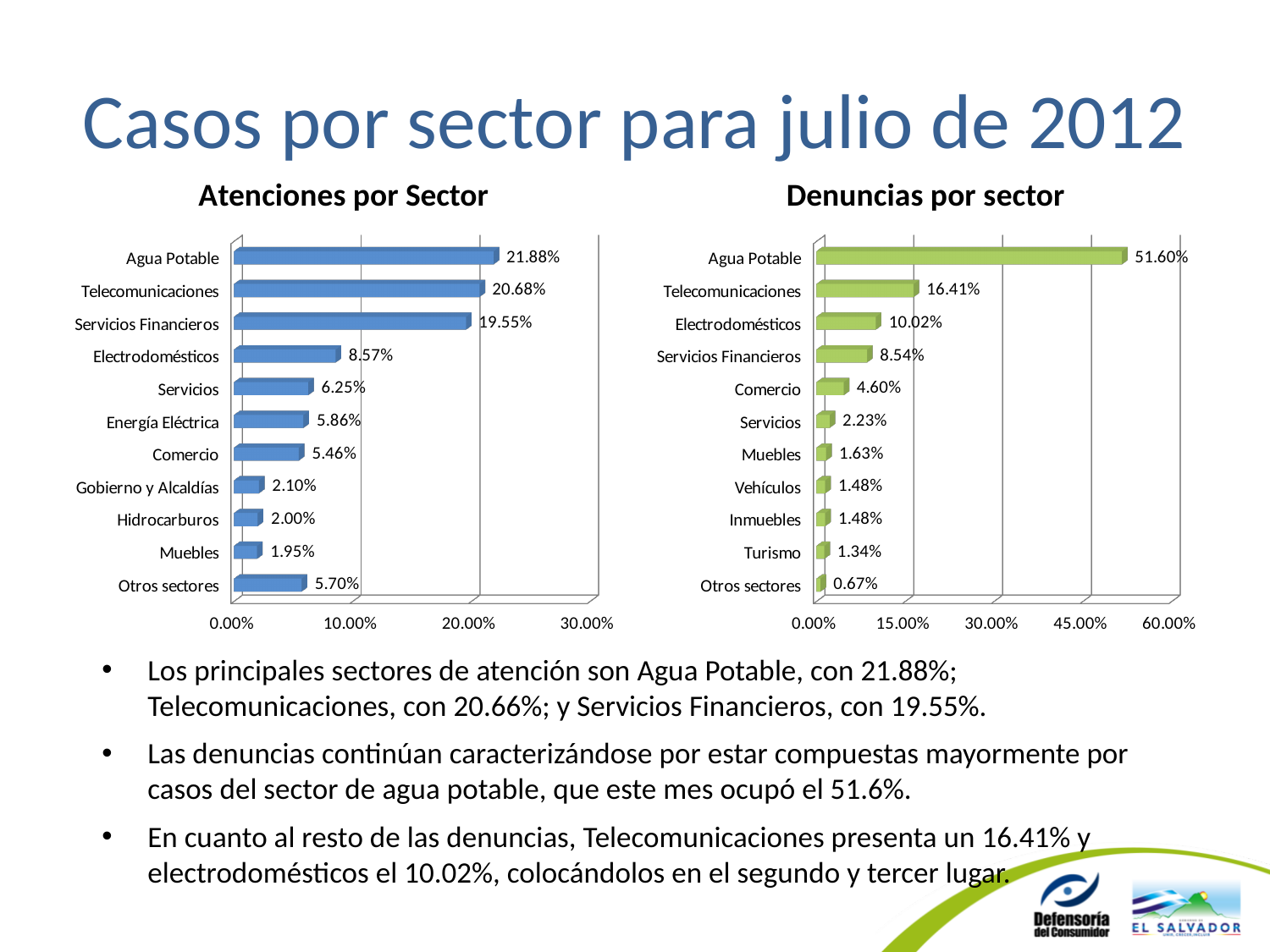
In the 'Atenciones por Sector' chart, which sector has the lowest value? Muebles In the 'Atenciones por Sector' chart, what is the value for Agua Potable? 21.88% In the 'Atenciones por Sector' chart, what is the difference between Agua Potable and Servicios Financieros? 2.33% In the 'Denuncias por sector' chart, is the value for Agua Potable greater or less than 45.00%? greater In the 'Denuncias por sector' chart, what is the difference between Electrodomésticos and Servicios Financieros? 1.48% What is the title of the chart on the right side of the slide? Denuncias por sector How many sectors are shown in the 'Denuncias por sector' chart? 11 In the 'Denuncias por sector' chart, what is the value for Telecomunicaciones? 16.41% In the 'Atenciones por Sector' chart, which is larger, Servicios or Comercio? Servicios In the 'Denuncias por sector' chart, which sector has the highest value? Agua Potable What kind of chart is 'Atenciones por Sector'? Bar chart In the 'Atenciones por Sector' chart, what is the value for Otros sectores? 5.70%